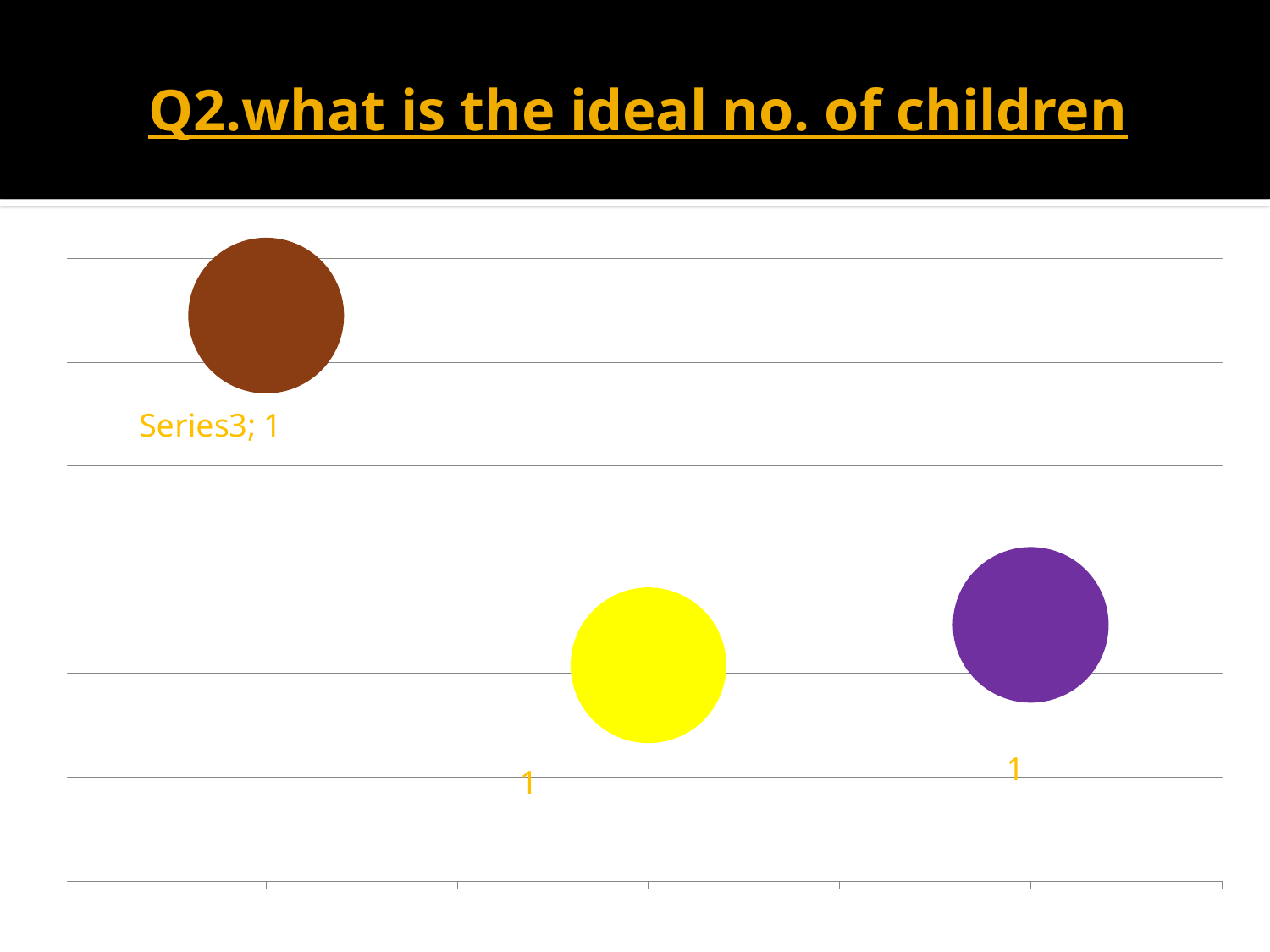
How many bubbles are plotted on the chart? 3 What is the data label shown next to the yellow bubble? 1 What colour is the bubble labelled Series3? brown Which bubble is positioned highest on the chart? the brown bubble (Series3) Which bubble is positioned higher on the chart, the brown one or the yellow one? the brown one Which bubble is positioned lowest on the chart? the yellow bubble What is the title of the chart on the slide? Q2.what is the ideal no. of children What kind of chart is shown on the slide? bubble chart What is the data label shown next to the purple bubble? 1 What value is shown in the data label for Series3? 1